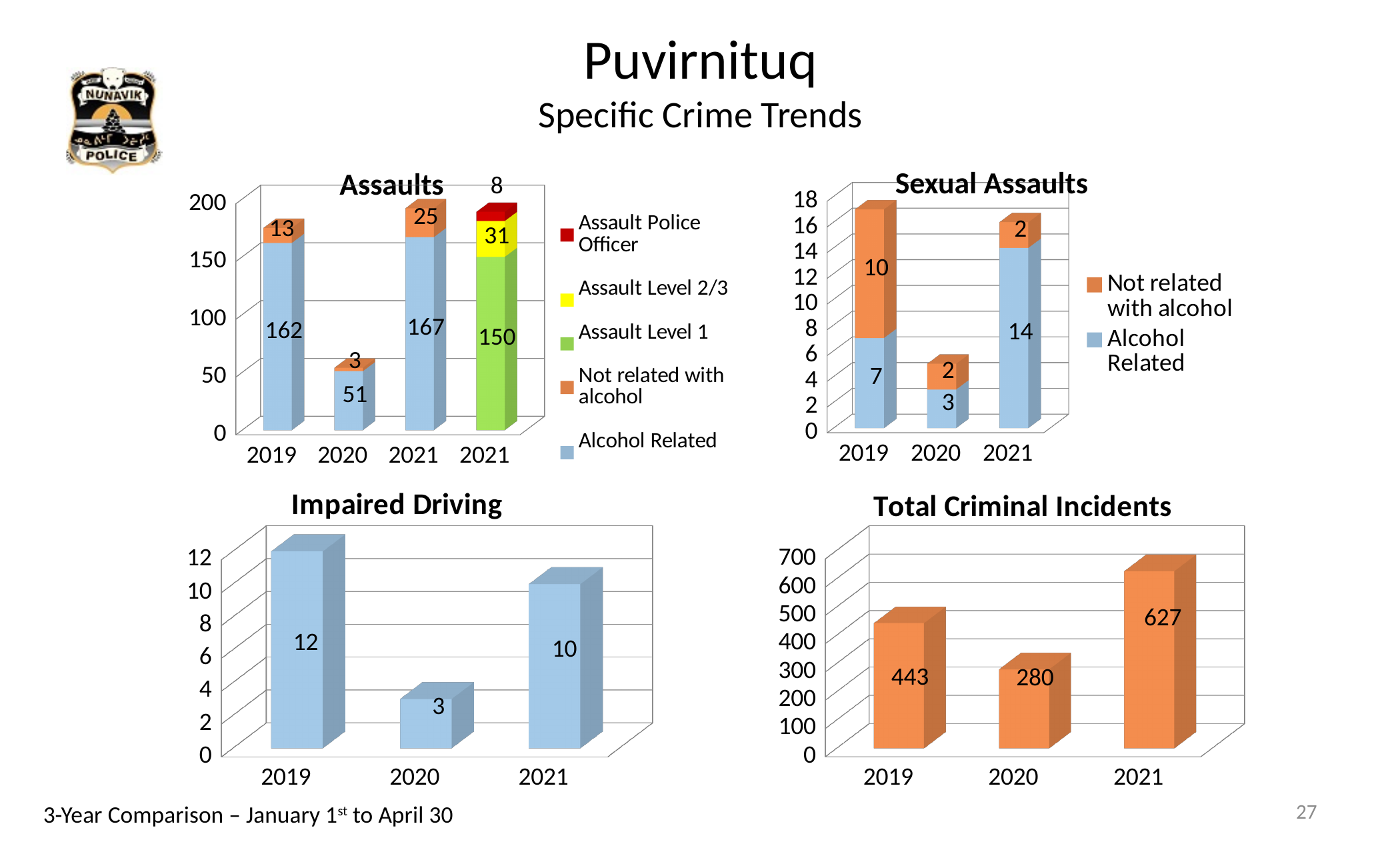
In the Total Criminal Incidents chart, what is the difference between the 2021 and 2019 values? 184 In the Impaired Driving chart, what is the value for 2020? 3 What kind of chart is the Total Criminal Incidents chart? Bar chart In the Assaults chart, what is the Alcohol Related value for 2020? 51 In the Sexual Assaults chart, what is the Alcohol Related value for 2021? 14 In the Total Criminal Incidents chart, what is the value for 2021? 627 In the Impaired Driving chart, how many years are shown on the x axis? 3 In the Sexual Assaults chart, what is the total of the stacked bar for 2019? 17 In the Sexual Assaults chart, how many series does the legend list? 2 In the Total Criminal Incidents chart, which year has the lowest value? 2020 In the Impaired Driving chart, which year has the highest value? 2019 In the Assaults chart, what is the Assault Level 2/3 value for the second 2021 bar? 31